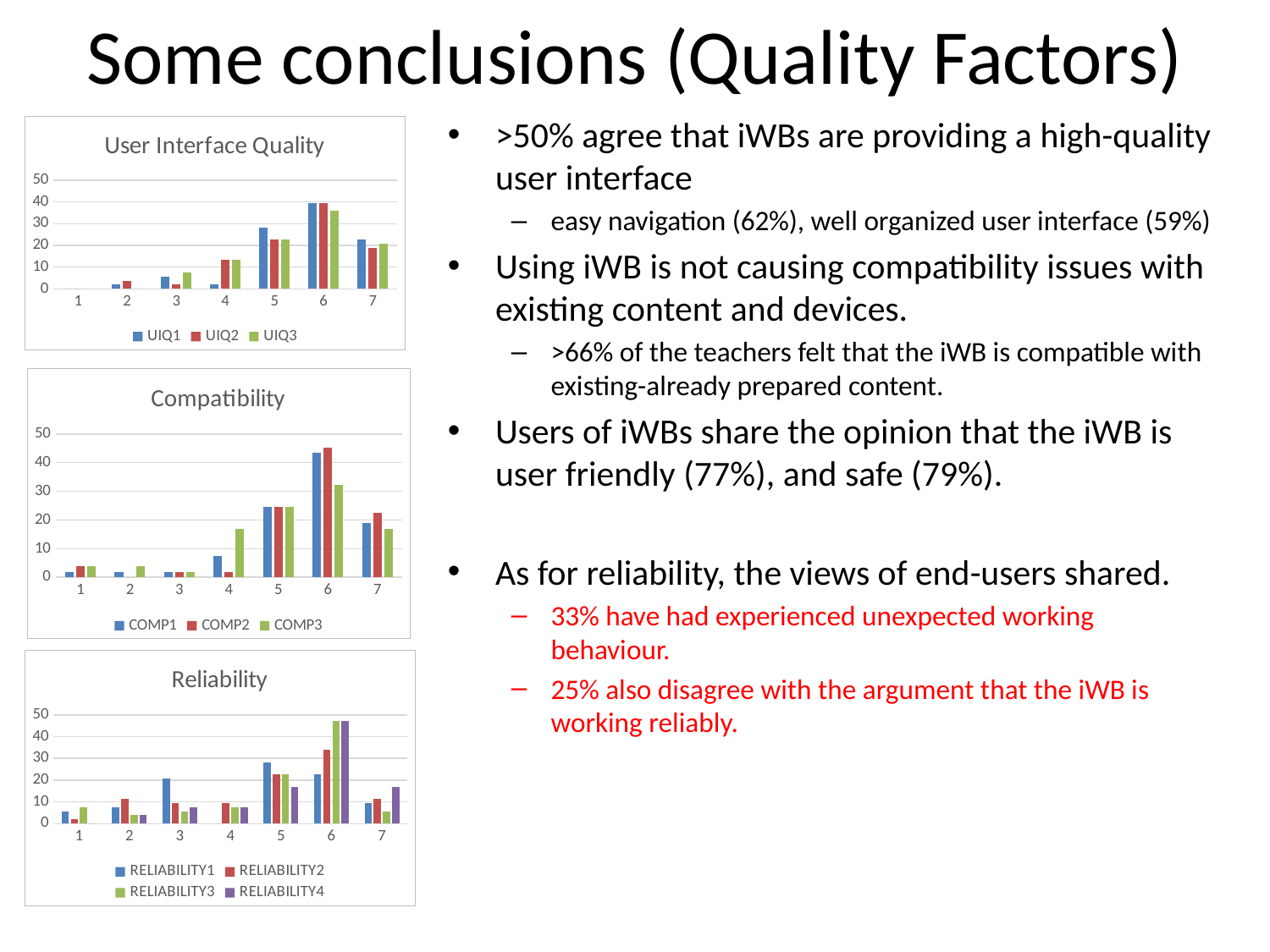
In the User Interface Quality chart, which category has the highest value for UIQ1? 6 In the User Interface Quality chart, is the value for UIQ1 at category 5 greater or less than 20? greater In the Compatibility chart, is the value for COMP3 at category 6 greater or less than 40? less How many series does the legend of the Compatibility chart list? 3 In the Compatibility chart, is the value for COMP2 at category 6 greater or less than 40? greater In the Reliability chart, which is larger at category 6: RELIABILITY1 or RELIABILITY2? RELIABILITY2 What is the title of the bottom chart on the slide? Reliability What type of chart is the User Interface Quality chart? bar chart How many series does the legend of the Reliability chart list? 4 How many categories are shown on the x axis of the User Interface Quality chart? 7 In the Compatibility chart, which category has the highest value for COMP2? 6